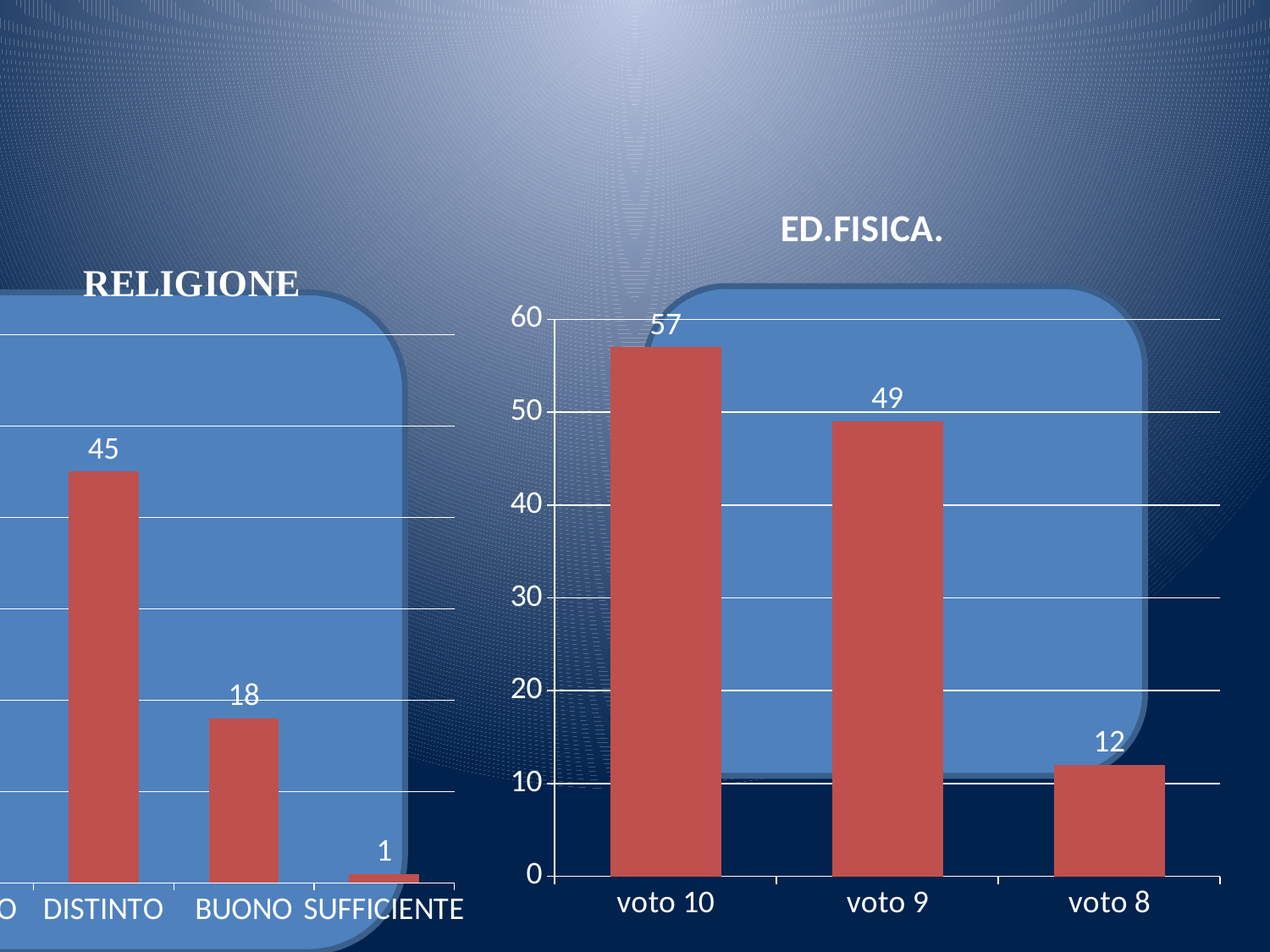
In the RELIGIONE chart, what is the value for DISTINTO? 45 In the ED.FISICA. chart, how many categories are shown on the x axis? 3 In the ED.FISICA. chart, what is the value for voto 10? 57 In the ED.FISICA. chart, do the values rise or fall from voto 10 to voto 8? fall In the ED.FISICA. chart, what is the value for voto 8? 12 In the ED.FISICA. chart, which category has the lowest value? voto 8 What kind of chart is the ED.FISICA. chart? bar chart In the ED.FISICA. chart, what is the difference between the values for voto 10 and voto 8? 45 In the RELIGIONE chart, what is the value for BUONO? 18 In the ED.FISICA. chart, which category has the highest value? voto 10 In the ED.FISICA. chart, what is the value for voto 9? 49 In the RELIGIONE chart, which is larger, the value for BUONO or the value for SUFFICIENTE? BUONO